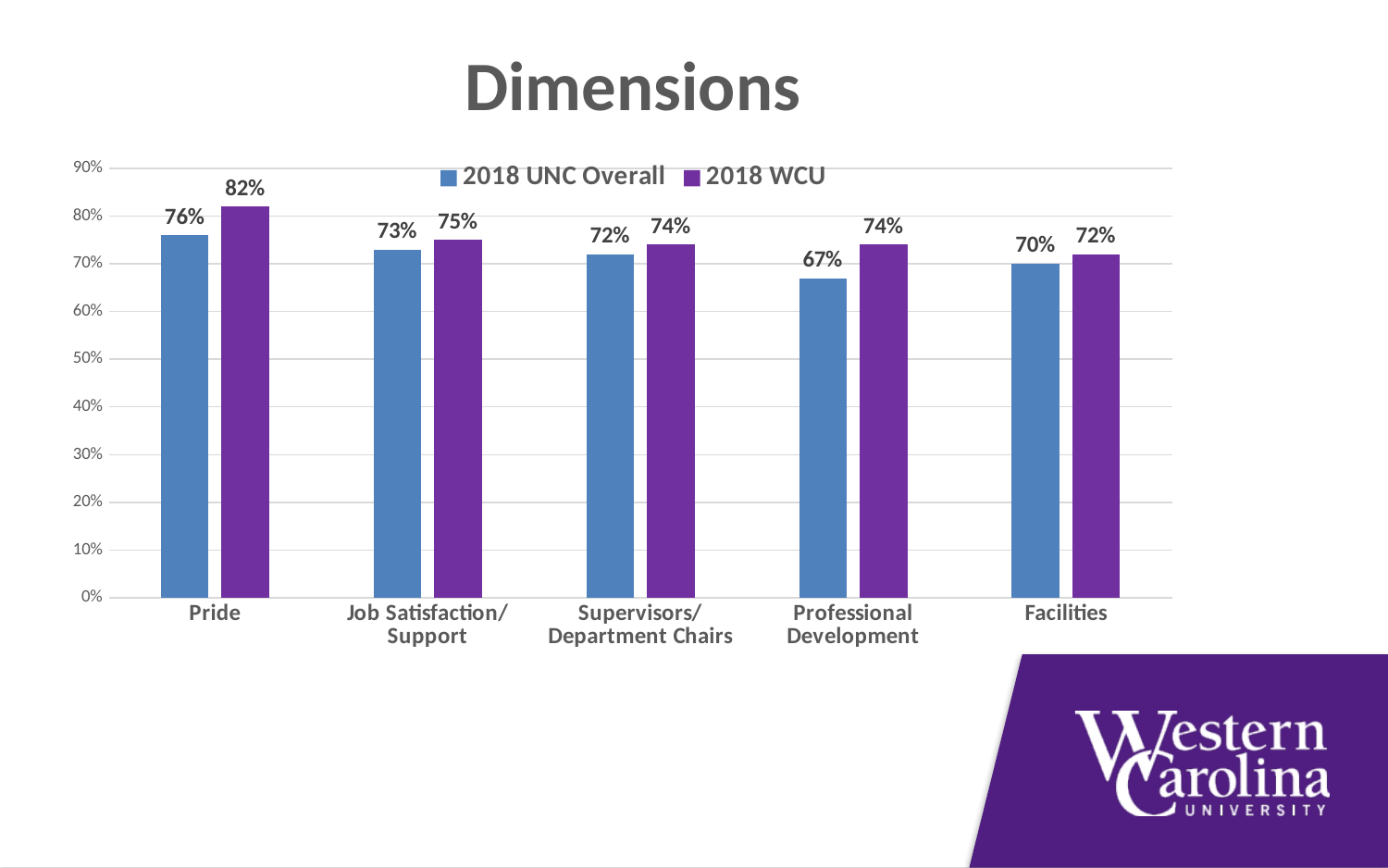
What is the 2018 UNC Overall value for Professional Development? 67% What is the difference between the 2018 WCU and 2018 UNC Overall values for Professional Development? 7% Which category has the lowest 2018 UNC Overall value? Professional Development What is the 2018 WCU value for Pride? 82% What is the 2018 WCU value for Facilities? 72% Which category has the highest 2018 WCU value? Pride Which is larger for Job Satisfaction/Support: the 2018 UNC Overall value or the 2018 WCU value? 2018 WCU What is the title of the slide? Dimensions How many series does the legend list? 2 How many categories are shown on the x axis? 5 What kind of chart is shown on the slide? Bar chart What is the difference between the 2018 WCU and 2018 UNC Overall values for Pride? 6%